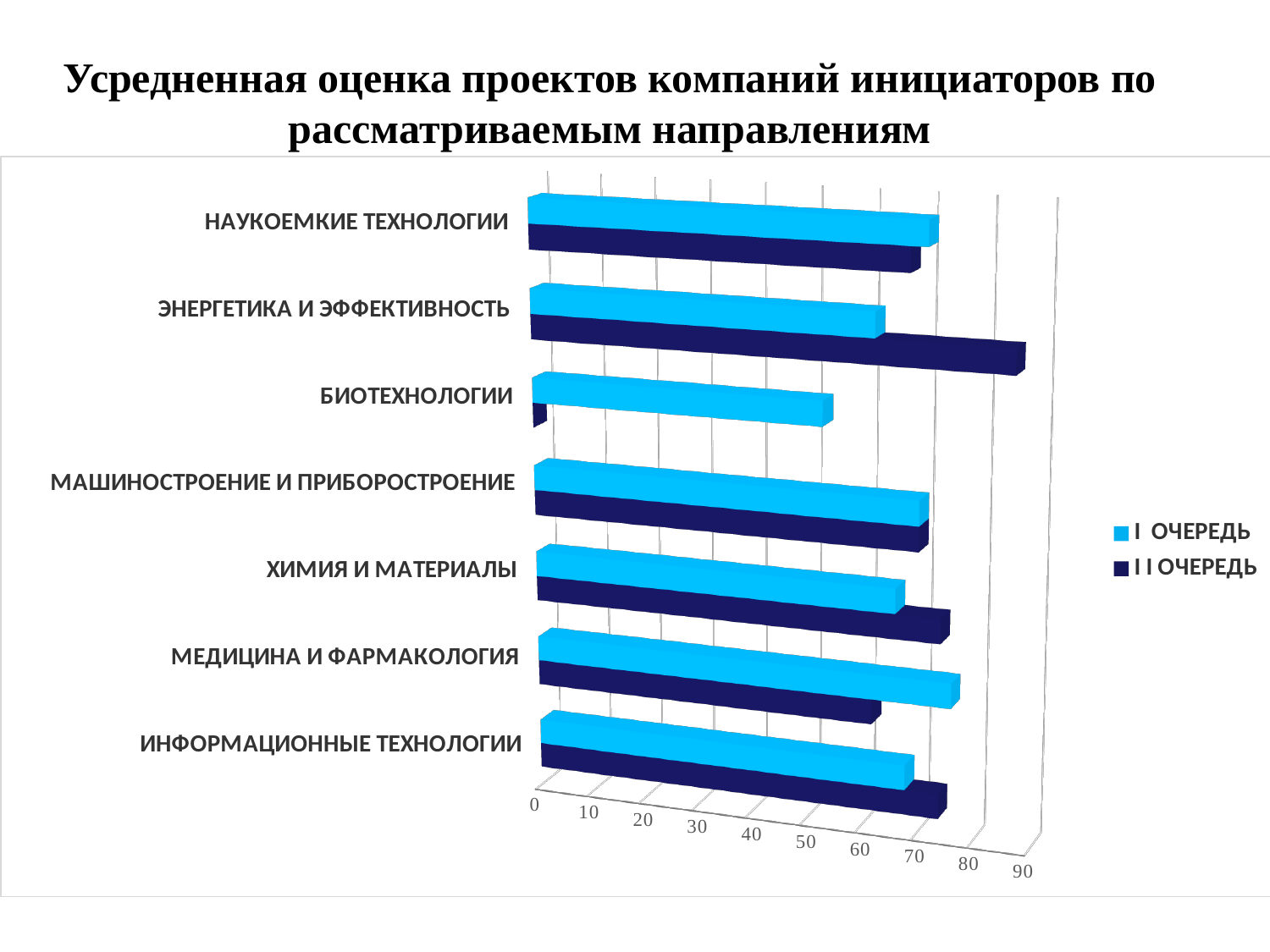
Is the II ОЧЕРЕДЬ value for БИОТЕХНОЛОГИИ greater or less than 10? less Which colour represents the I ОЧЕРЕДЬ series in the legend? light blue How many categories (directions) are shown on the chart? 7 For ЭНЕРГЕТИКА И ЭФФЕКТИВНОСТЬ, which series has the larger value, I ОЧЕРЕДЬ or II ОЧЕРЕДЬ? II ОЧЕРЕДЬ For БИОТЕХНОЛОГИИ, which series has the larger value, I ОЧЕРЕДЬ or II ОЧЕРЕДЬ? I ОЧЕРЕДЬ Which category has the lowest value for the II ОЧЕРЕДЬ series? БИОТЕХНОЛОГИИ What is the title of the chart on the slide? Усредненная оценка проектов компаний инициаторов по рассматриваемым направлениям How many series does the legend list? 2 What kind of chart is shown on the slide? bar chart Which category has the lowest value for the I ОЧЕРЕДЬ series? БИОТЕХНОЛОГИИ Is the II ОЧЕРЕДЬ value for ЭНЕРГЕТИКА И ЭФФЕКТИВНОСТЬ greater or less than 70? greater Which category has the highest value for the II ОЧЕРЕДЬ series? ЭНЕРГЕТИКА И ЭФФЕКТИВНОСТЬ